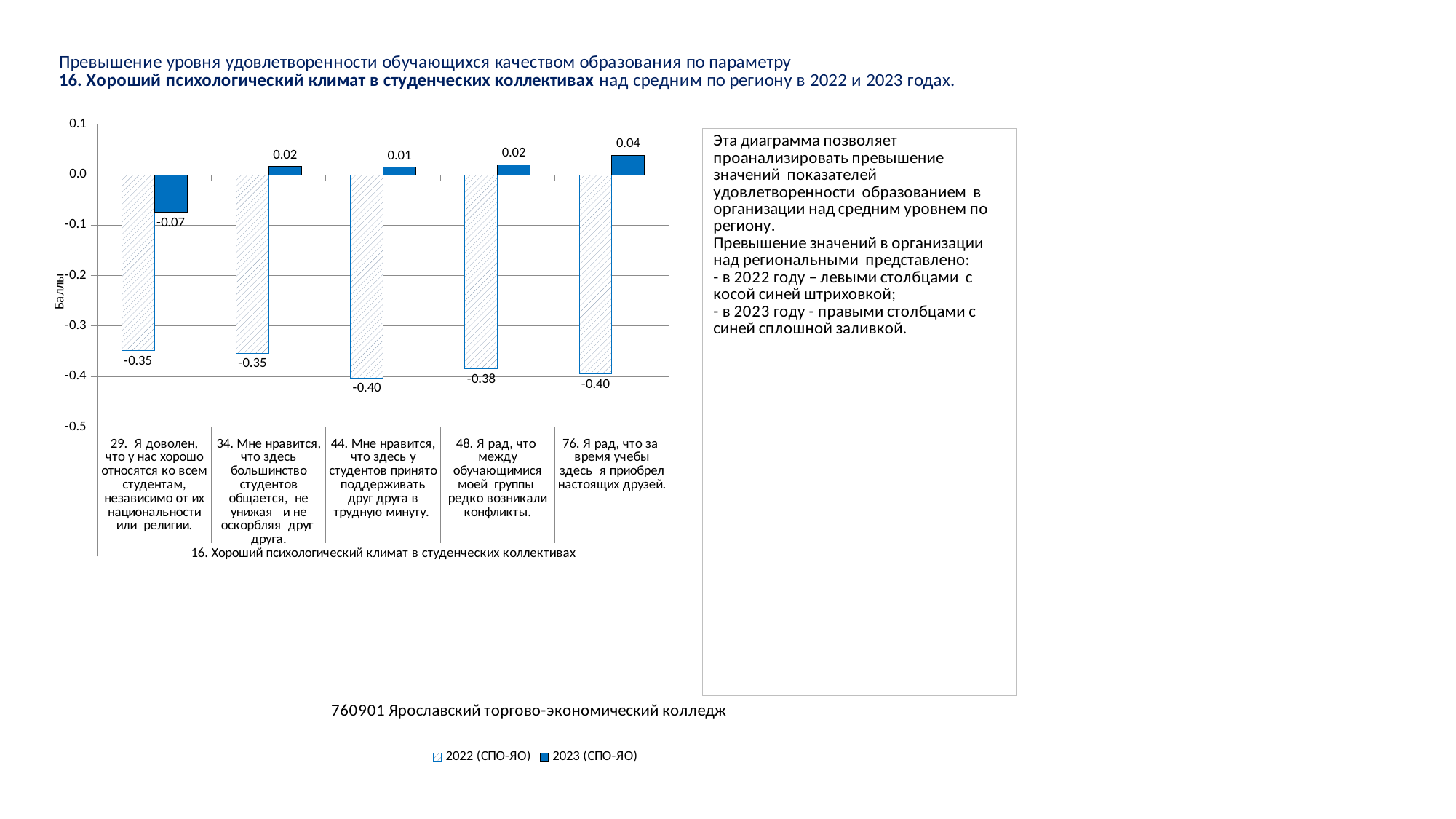
What is the difference between the 2023 (СПО-ЯО) and 2022 (СПО-ЯО) values for item 76 (Я рад, что за время учебы здесь я приобрел настоящих друзей)? 0.44 How many items (categories) are shown on the x axis of the chart? 5 How many series does the chart legend list? 2 What type of chart is shown on the slide? Bar chart What is the value for the 2022 (СПО-ЯО) series for item 29 (Я доволен, что у нас хорошо относятся ко всем студентам...)? -0.35 Which item has the highest value in the 2023 (СПО-ЯО) series? 76. Я рад, что за время учебы здесь я приобрел настоящих друзей. What is the value for the 2022 (СПО-ЯО) series for item 44 (Мне нравится, что здесь у студентов принято поддерживать друг друга в трудную минуту)? -0.40 What is the value for the 2023 (СПО-ЯО) series for item 76 (Я рад, что за время учебы здесь я приобрел настоящих друзей)? 0.04 What is the value for the 2023 (СПО-ЯО) series for item 29 (Я доволен, что у нас хорошо относятся ко всем студентам...)? -0.07 For item 48 (Я рад, что между обучающимися моей группы редко возникали конфликты), which series has the larger value, 2022 (СПО-ЯО) or 2023 (СПО-ЯО)? 2023 (СПО-ЯО) Which item has the lowest value in the 2023 (СПО-ЯО) series? 29. Я доволен, что у нас хорошо относятся ко всем студентам, независимо от их национальности или религии. What is the title of the vertical axis of the chart? Баллы